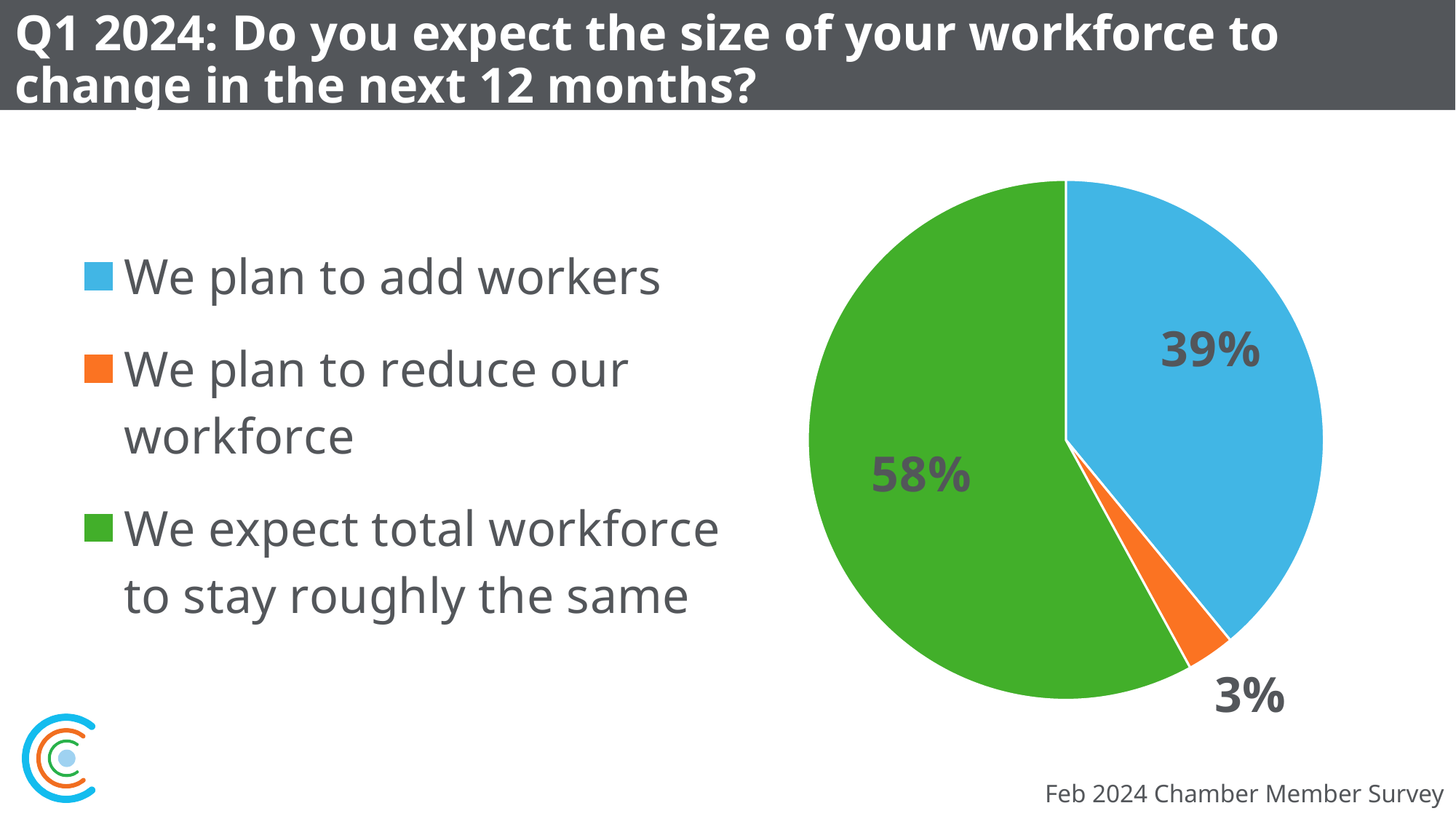
Which response has the smallest share of the pie? We plan to reduce our workforce Which response has the largest share of the pie? We expect total workforce to stay roughly the same What colour represents 'We plan to reduce our workforce' in the pie chart? Orange What is the source noted at the bottom of the slide? Feb 2024 Chamber Member Survey What is the difference in percentage points between those who expect the workforce to stay roughly the same and those who plan to add workers? 19 What percentage of respondents plan to add workers? 39% What is the combined percentage of respondents who plan to add workers or reduce their workforce? 42% What percentage of respondents plan to reduce their workforce? 3% What kind of chart is shown on the slide? Pie chart How many categories does the pie chart show? 3 Which is larger: the share planning to add workers or the share planning to reduce their workforce? We plan to add workers What percentage of respondents expect total workforce to stay roughly the same? 58%